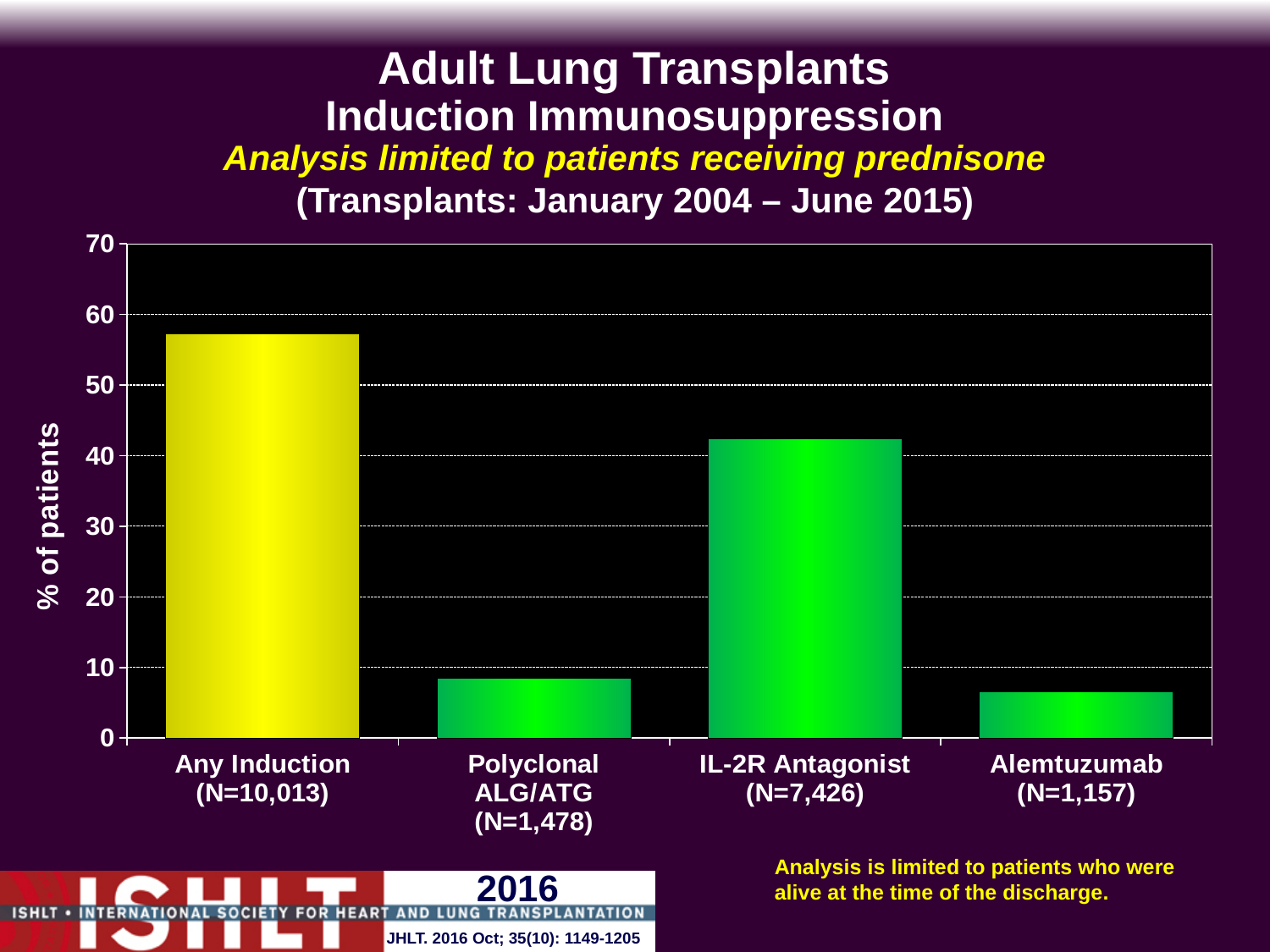
Is the value for Alemtuzumab greater or less than 10? less Which category has the lowest percentage of patients? Alemtuzumab What is the label of the y axis? % of patients What is the N shown for the IL-2R Antagonist category? N=7,426 Which is larger, the value for IL-2R Antagonist or the value for Polyclonal ALG/ATG? IL-2R Antagonist What kind of chart is shown on the slide? bar chart Is the value for Polyclonal ALG/ATG greater or less than 10? less Which category has the highest percentage of patients? Any Induction How many categories are plotted on the chart? 4 Is the value for Any Induction greater or less than 60? less